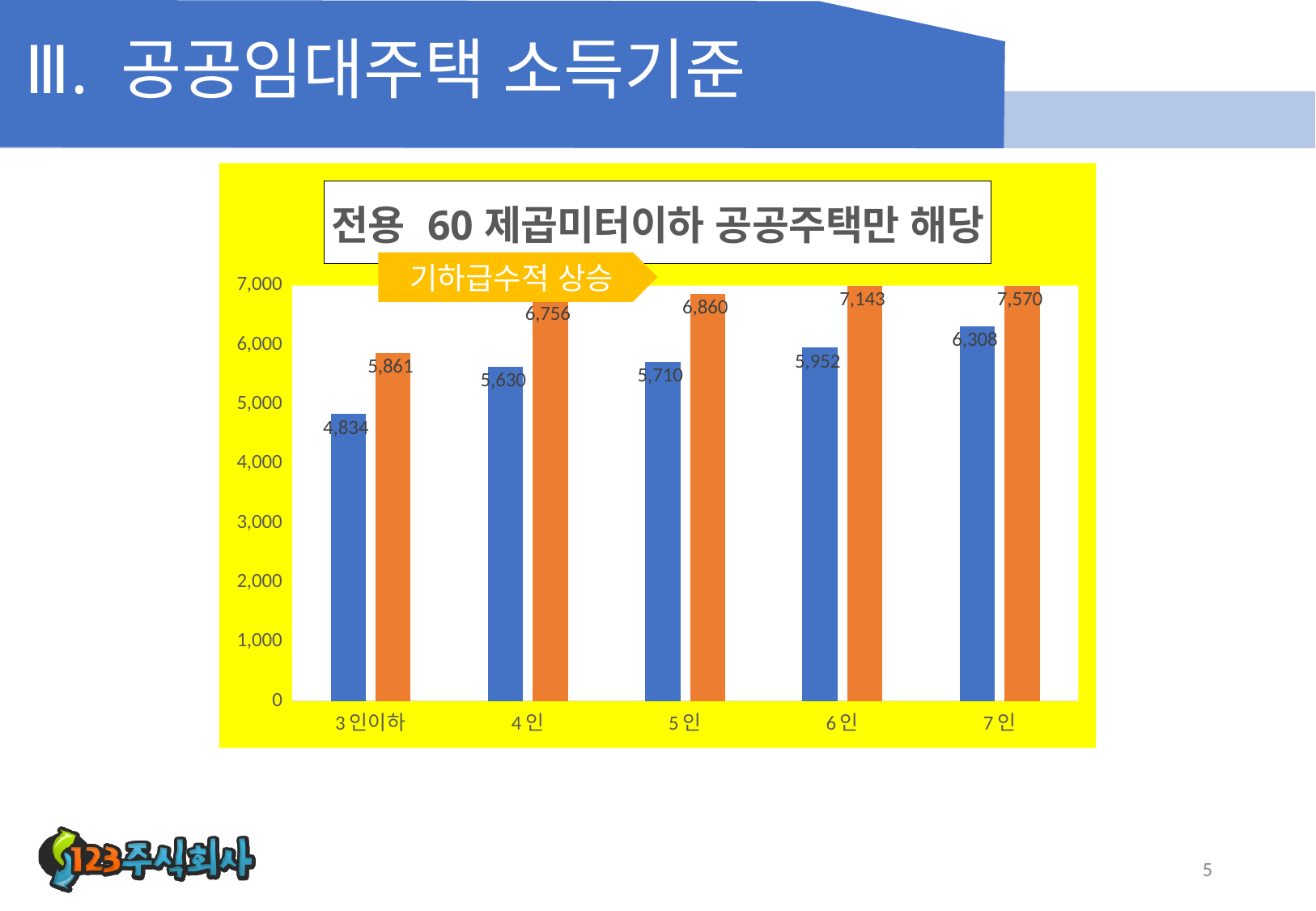
What is the difference between the orange bar and the blue bar for 4인? 1,126 Which is larger for 5인, the blue bar or the orange bar? the orange bar Which category has the highest orange bar? 7인 What type of chart is shown on the slide? bar chart What is the value of the blue bar for 3인이하? 4,834 What is the value of the orange bar for 7인? 7,570 How many household-size categories are shown on the x axis of the chart? 5 What is the title of the chart? 전용 60 제곱미터이하 공공주택만 해당 Do the blue bar values rise or fall from 3인이하 to 7인? rise Which category has the lowest blue bar? 3인이하 What is the value of the orange bar for 5인? 6,860 What is the value of the blue bar for 6인? 5,952